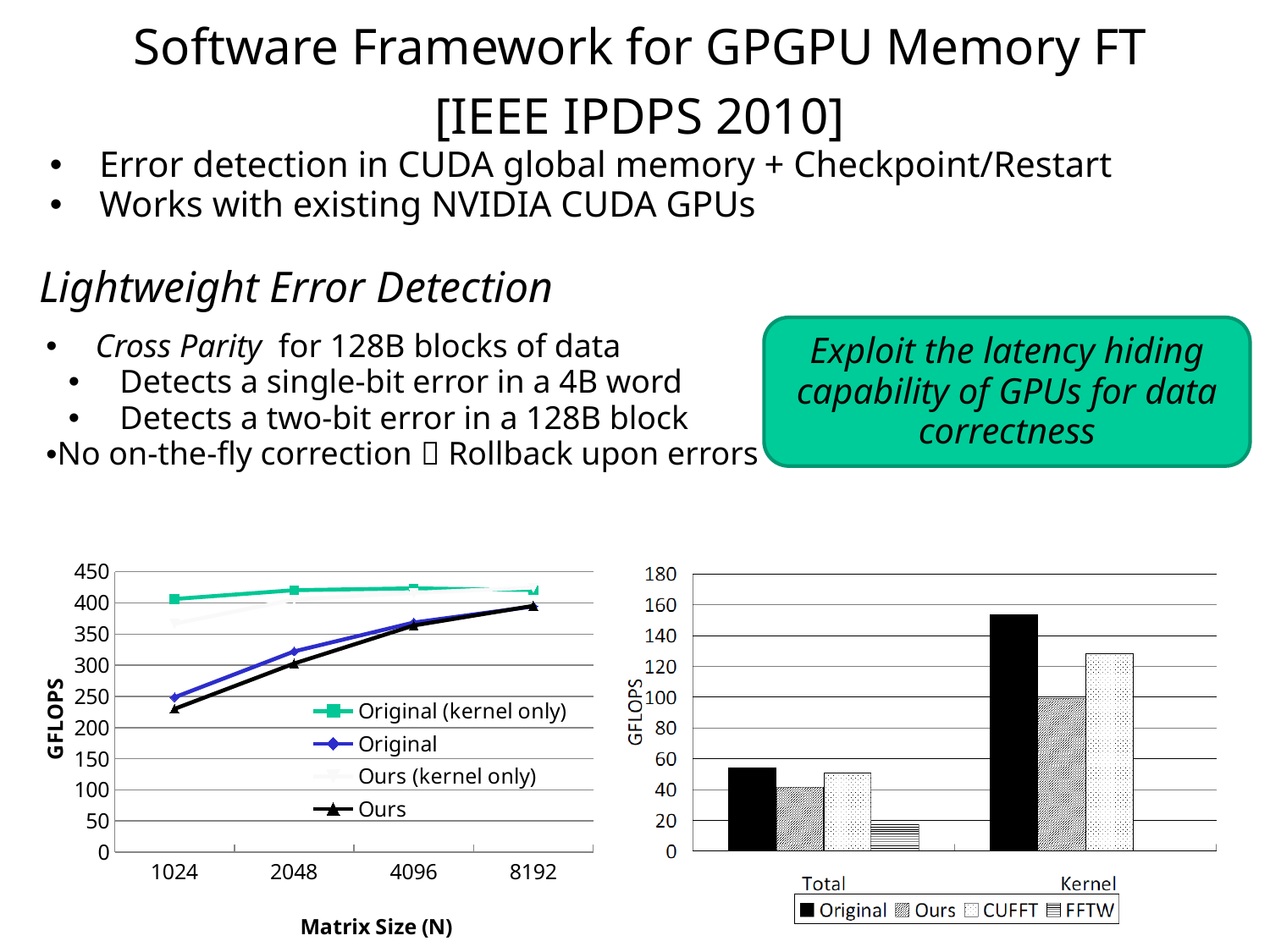
What kind of chart is the chart on the right of the slide (Total and Kernel)? bar chart In the left chart, how many matrix sizes are shown on the x axis? 4 In the right chart, how many series does the legend list? 4 In the right chart, which series has the highest value in the Kernel group? Original What kind of chart is the chart on the left of the slide (GFLOPS vs Matrix Size)? line chart In the right chart, which series has the lowest value in the Total group? FFTW In the left chart, does the GFLOPS value for the Ours series rise or fall as the matrix size increases? rise In the left chart, is the value for Original (kernel only) at matrix size 2048 greater or less than 400? greater In the left chart, how many series does the legend list? 4 In the right chart, is the value for Ours in the Total group greater or less than 50? less In the left chart, which series has the highest GFLOPS at matrix size 1024? Original (kernel only) In the left chart, is the value for Ours at matrix size 1024 greater or less than 250? less